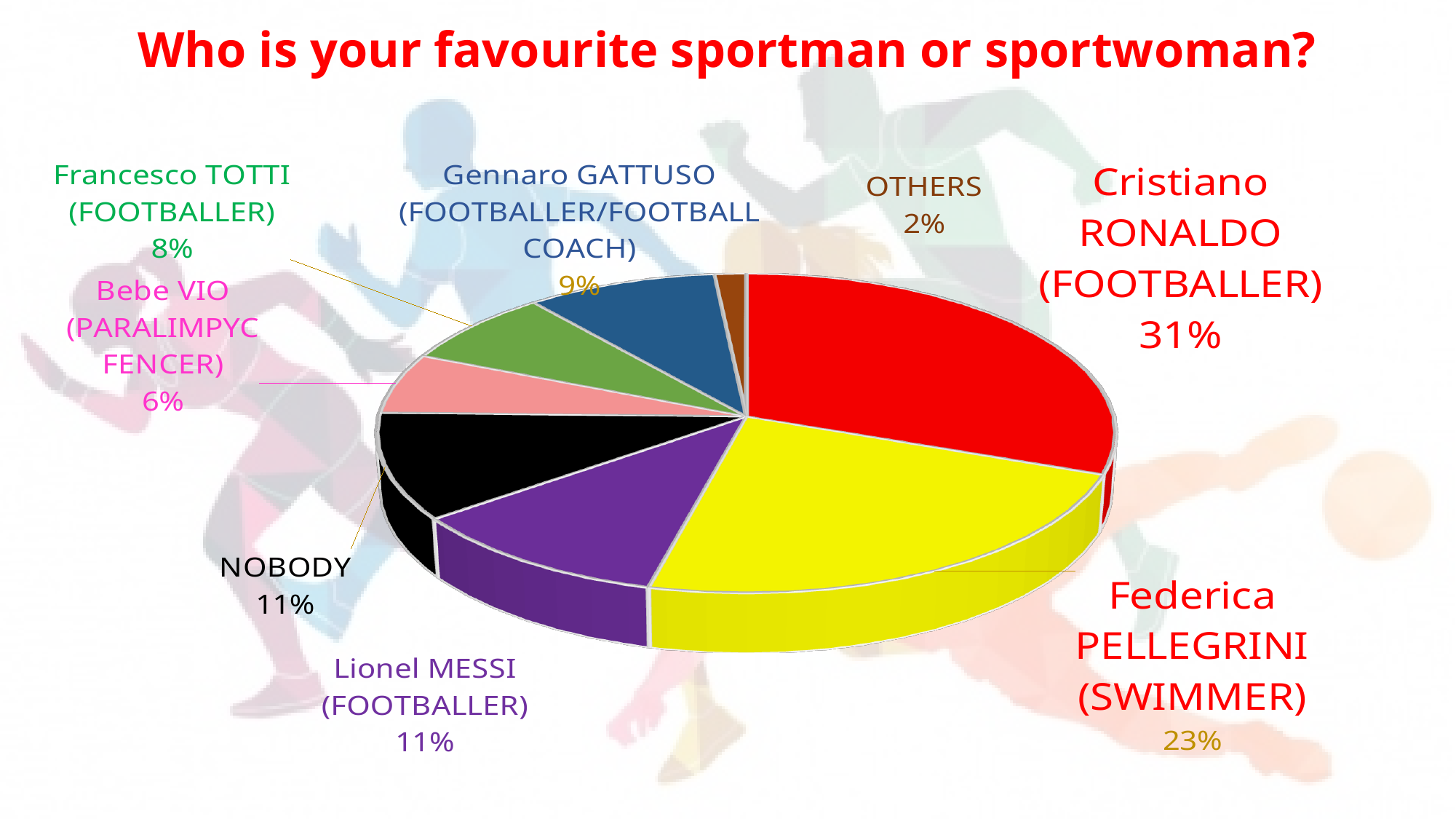
Which is larger, the share for Francesco TOTTI (FOOTBALLER) or the share for Bebe VIO (PARALIMPYC FENCER)? Francesco TOTTI (FOOTBALLER) How many slices does the pie chart have? 8 What is the difference in percentage points between Cristiano RONALDO (FOOTBALLER) and Federica PELLEGRINI (SWIMMER)? 8 What percentage is shown for Bebe VIO (PARALIMPYC FENCER)? 6% What percentage is shown for Federica PELLEGRINI (SWIMMER)? 23% Which category has the largest slice of the pie? Cristiano RONALDO (FOOTBALLER) What colour is the slice for Lionel MESSI (FOOTBALLER)? Purple What kind of chart is shown on the slide? Pie chart What share of the pie does Cristiano RONALDO (FOOTBALLER) have? 31% What percentage is shown for Gennaro GATTUSO (FOOTBALLER/FOOTBALL COACH)? 9% What is the title of the slide? Who is your favourite sportman or sportwoman? Which category has the smallest slice of the pie? OTHERS